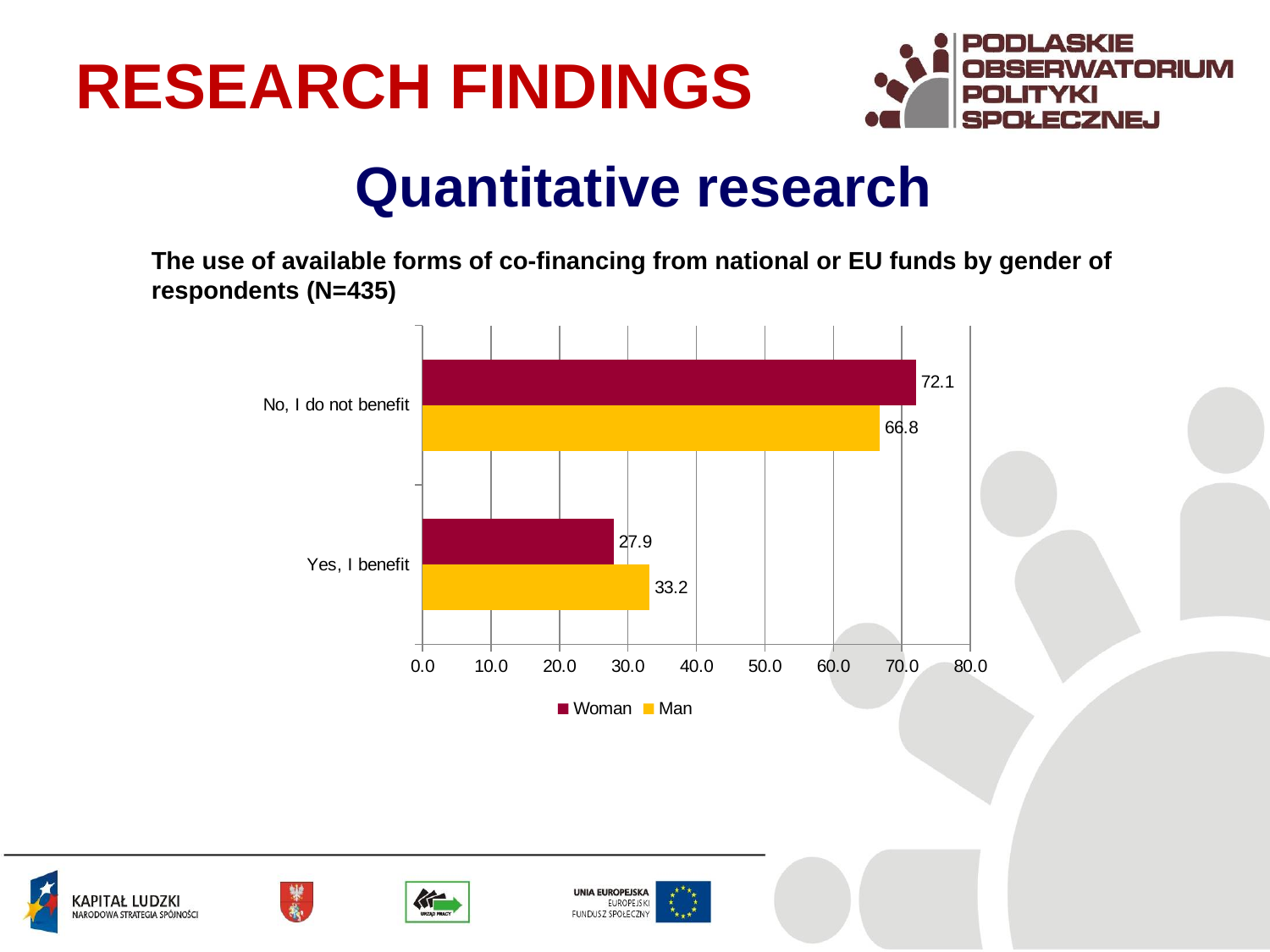
Which category has the lowest value for the Man series? Yes, I benefit What is the difference between the Woman and Man values in the "No, I do not benefit" category? 5.3 Which category has the highest value for the Woman series? No, I do not benefit In the "Yes, I benefit" category, which series has the larger value, Woman or Man? Man What is the value for Man in the "Yes, I benefit" category? 33.2 What is the difference between the Man and Woman values in the "Yes, I benefit" category? 5.3 How many series does the legend list? 2 What is the value for Woman in the "No, I do not benefit" category? 72.1 How many categories are shown on the chart? 2 What is the value for Man in the "No, I do not benefit" category? 66.8 What kind of chart is shown on the slide? Bar chart What is the value for Woman in the "Yes, I benefit" category? 27.9